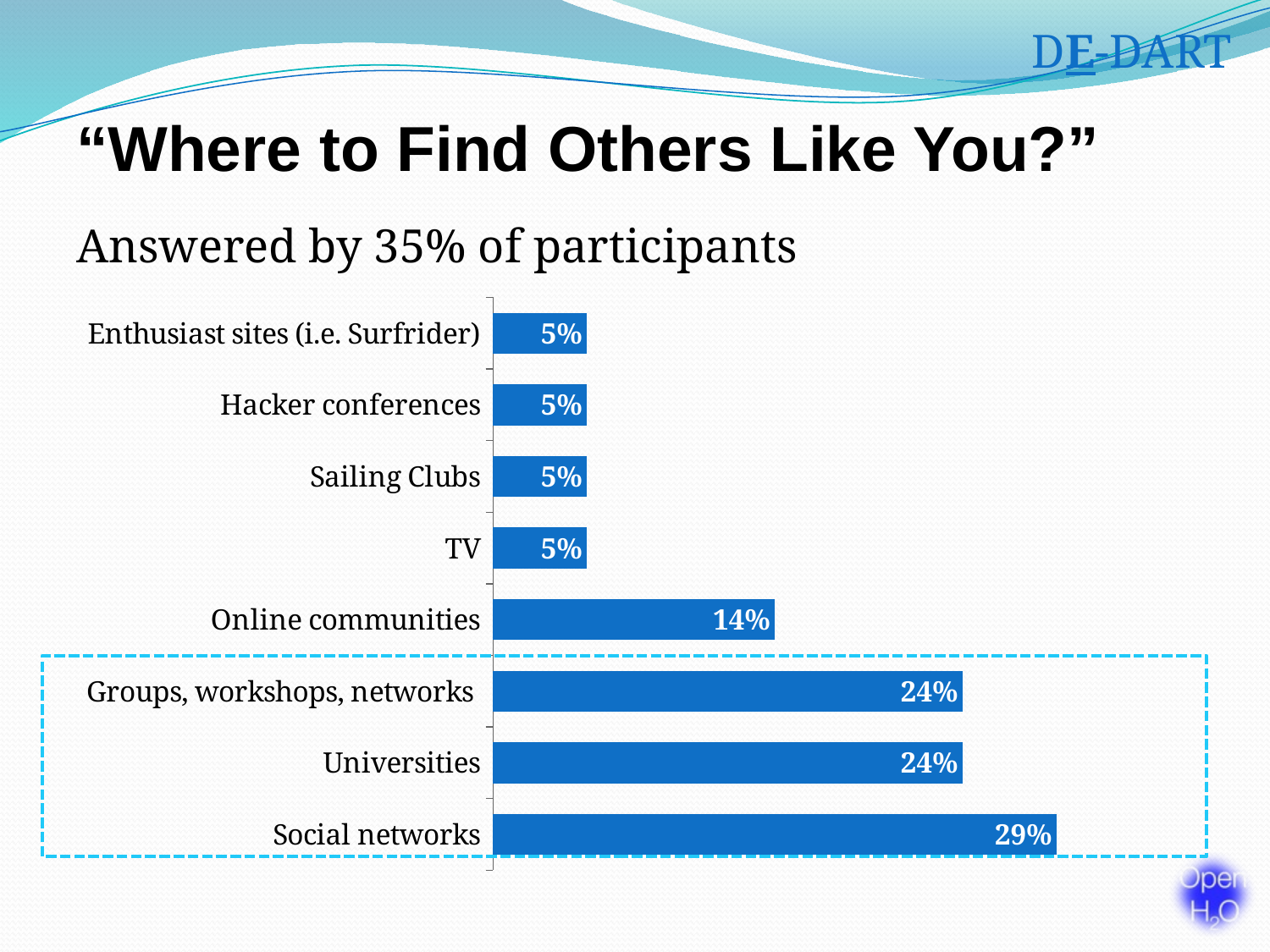
What is the difference between the values for Social networks and Online communities? 15% What kind of chart is shown on the slide? Bar chart What is the value for Universities? 24% Which category has the highest value? Social networks How many categories are shown in the chart? 8 What is the value for Hacker conferences? 5% How many categories have a value of 5%? 4 What is the title of the slide above the chart? "Where to Find Others Like You?" What is the difference between the values for Groups, workshops, networks and TV? 19% What is the value for Online communities? 14% Which is larger, the value for Online communities or the value for Sailing Clubs? Online communities What is the value for Social networks? 29%